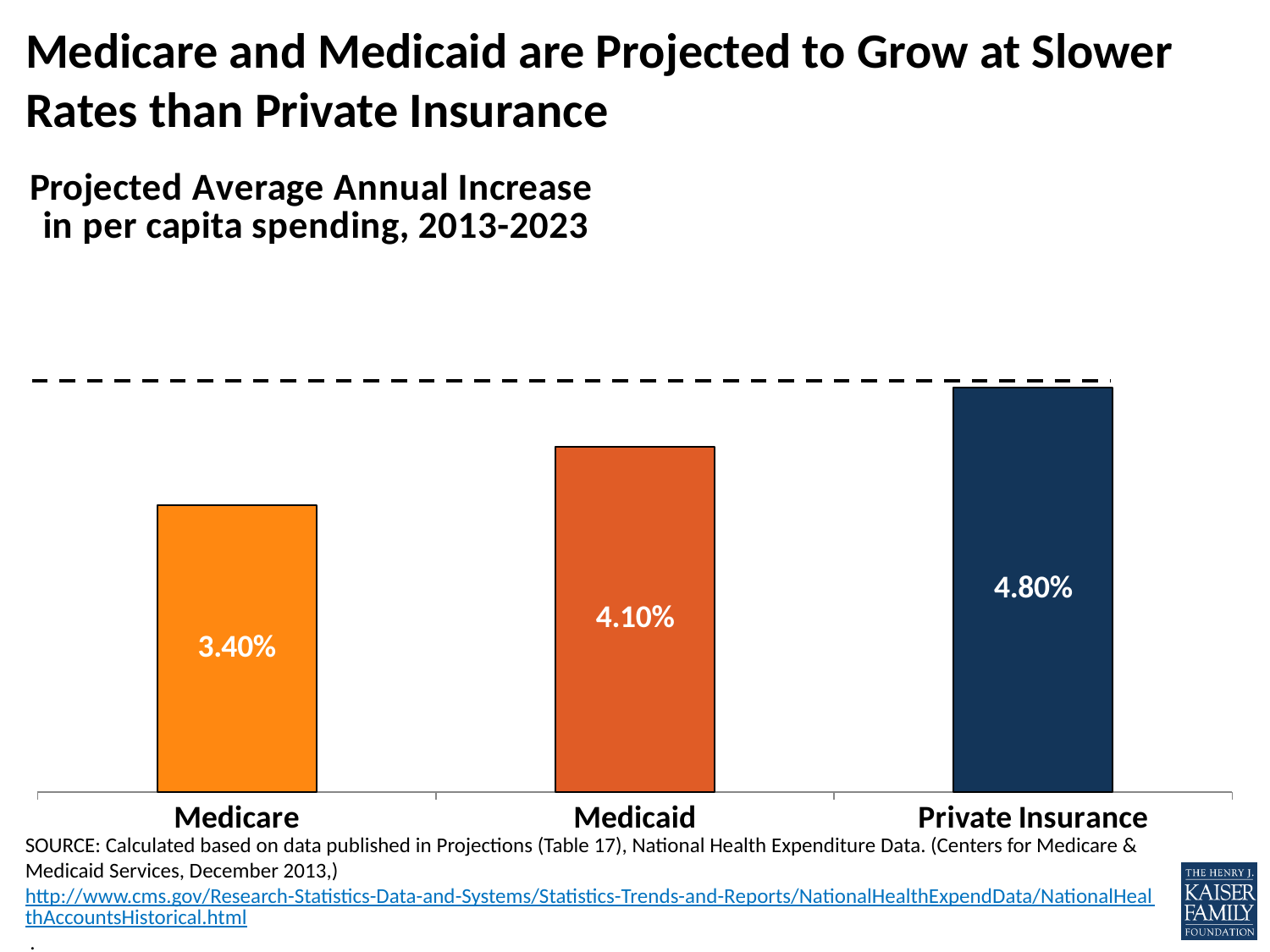
Which category has the lowest projected average annual increase? Medicare What is the projected average annual increase in per capita spending for Medicare? 3.40% Which category has the highest projected average annual increase? Private Insurance Do the values rise or fall from Medicare to Private Insurance along the x axis? Rise What is the difference between the projected increase for Medicaid and Medicare? 0.70% What time period does the chart subtitle say the projections cover? 2013-2023 Which has a larger projected increase, Medicaid or Private Insurance? Private Insurance How many categories are shown in the chart? 3 What is the projected average annual increase in per capita spending for Private Insurance? 4.80% What kind of chart is shown on the slide? Bar chart What is the projected average annual increase in per capita spending for Medicaid? 4.10% What is the difference between the projected increase for Private Insurance and Medicare? 1.40%